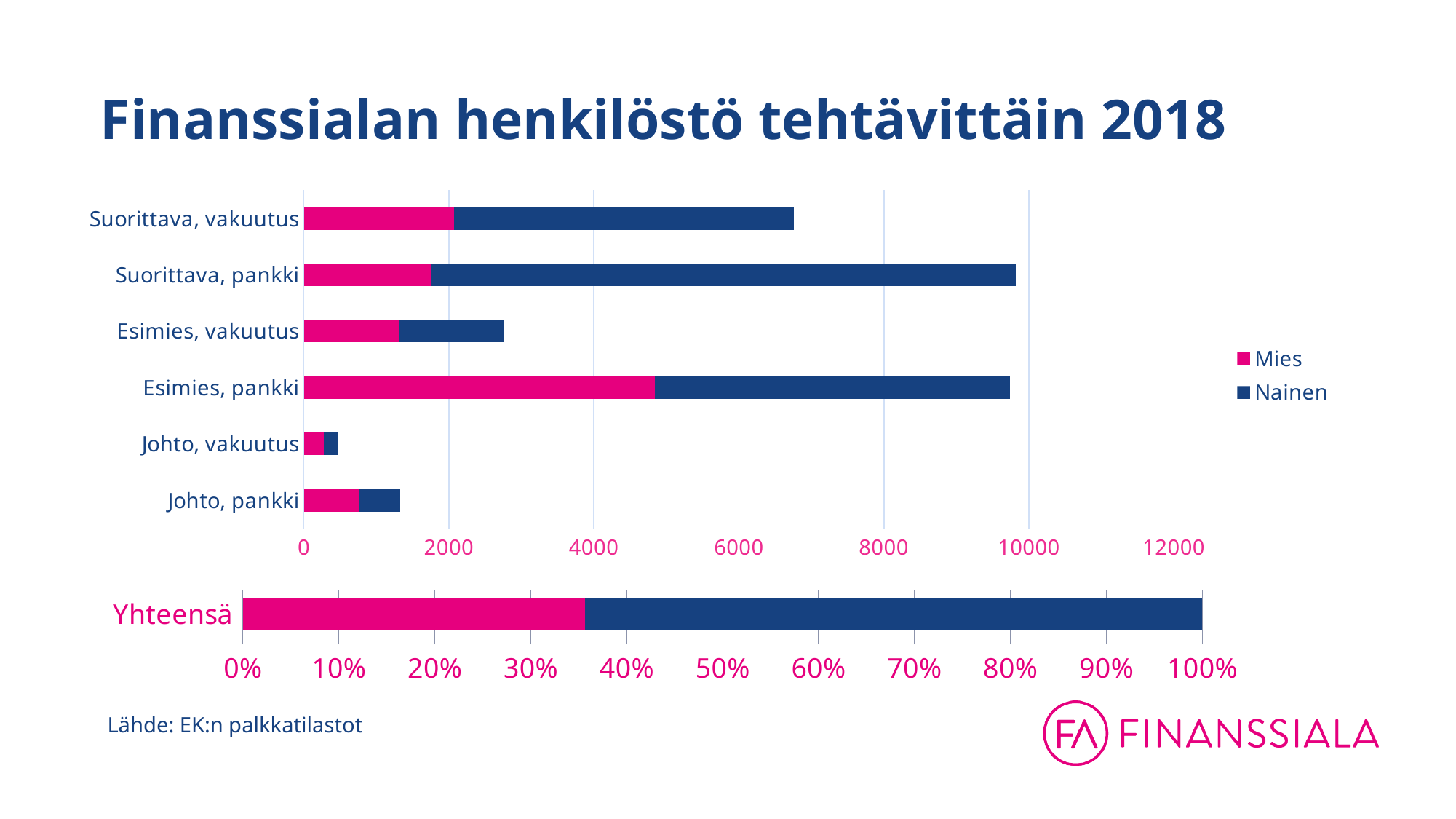
In the top chart, which category has the shortest total bar? Johto, vakuutus What kind of chart is the top chart on the slide? bar chart In the top chart, which has the longer total bar: Johto, pankki or Johto, vakuutus? Johto, pankki What are the two entries in the legend? Mies, Nainen In the bottom Yhteensä chart, is the Mies share greater or less than 40%? less How many series does the legend list? 2 In the top chart, which category has the longest Mies segment? Esimies, pankki In the top chart, is the Mies segment for Esimies, pankki greater or less than 4000? greater In the top chart, is the total bar for Suorittava, vakuutus greater or less than 6000? greater In the top chart, how many categories are shown on the vertical axis? 6 In the top chart, which has the longer total bar: Suorittava, vakuutus or Esimies, vakuutus? Suorittava, vakuutus